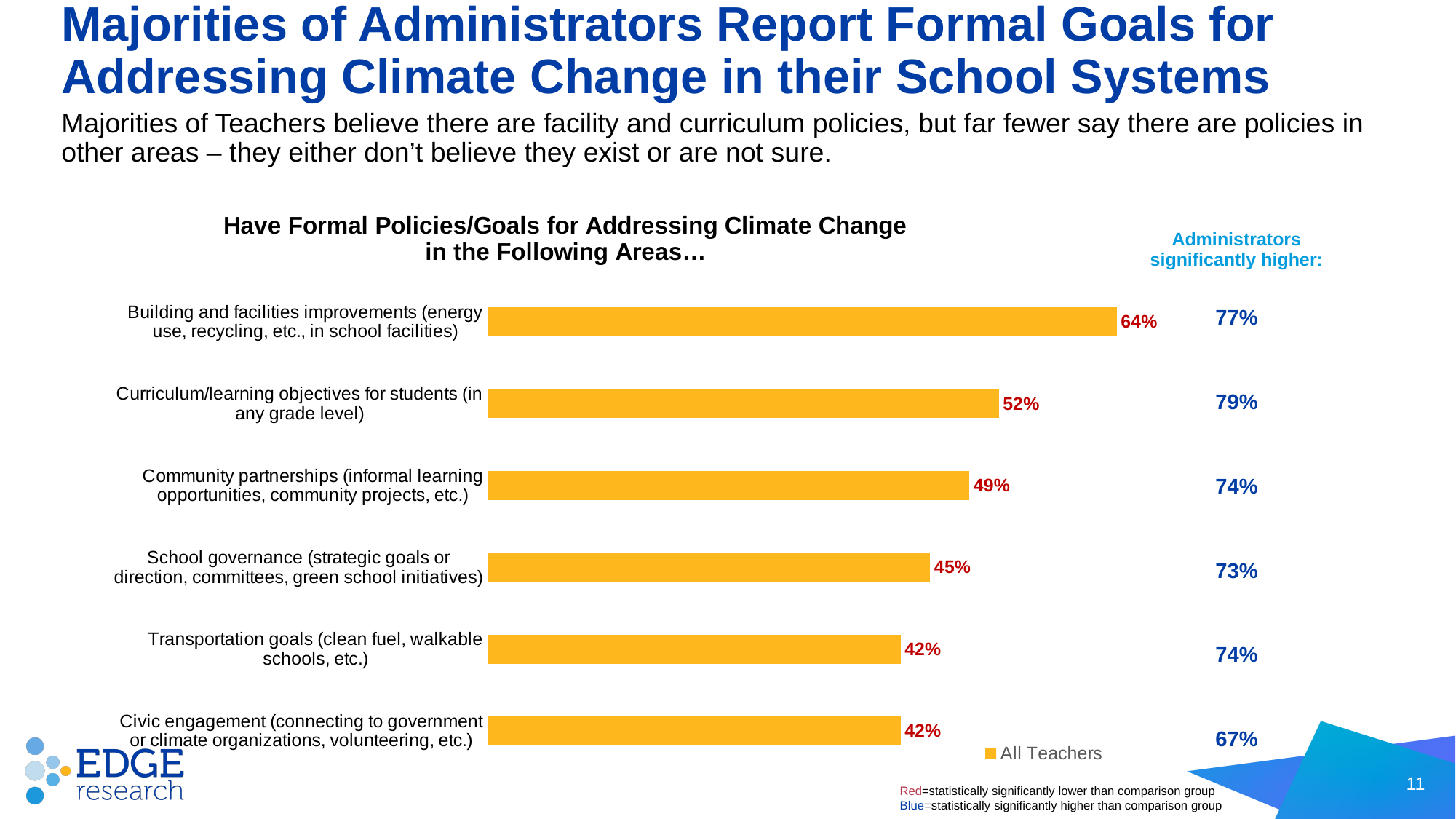
What is the name of the series shown in the chart legend? All Teachers Which area has the highest All Teachers value? Building and facilities improvements What percentage of All Teachers report formal policies/goals for Building and facilities improvements? 64% Which has a larger All Teachers value: Community partnerships or School governance? Community partnerships What is the All Teachers value for Curriculum/learning objectives for students? 52% How many areas (categories) are shown in the bar chart? 6 What is the All Teachers value for Community partnerships? 49% How many series does the chart legend list? 1 What is the All Teachers value for School governance? 45% What is the difference between the All Teachers values for Building and facilities improvements and Curriculum/learning objectives for students? 12% What type of chart is shown on the slide? Bar chart What is the lowest All Teachers value shown in the chart? 42%